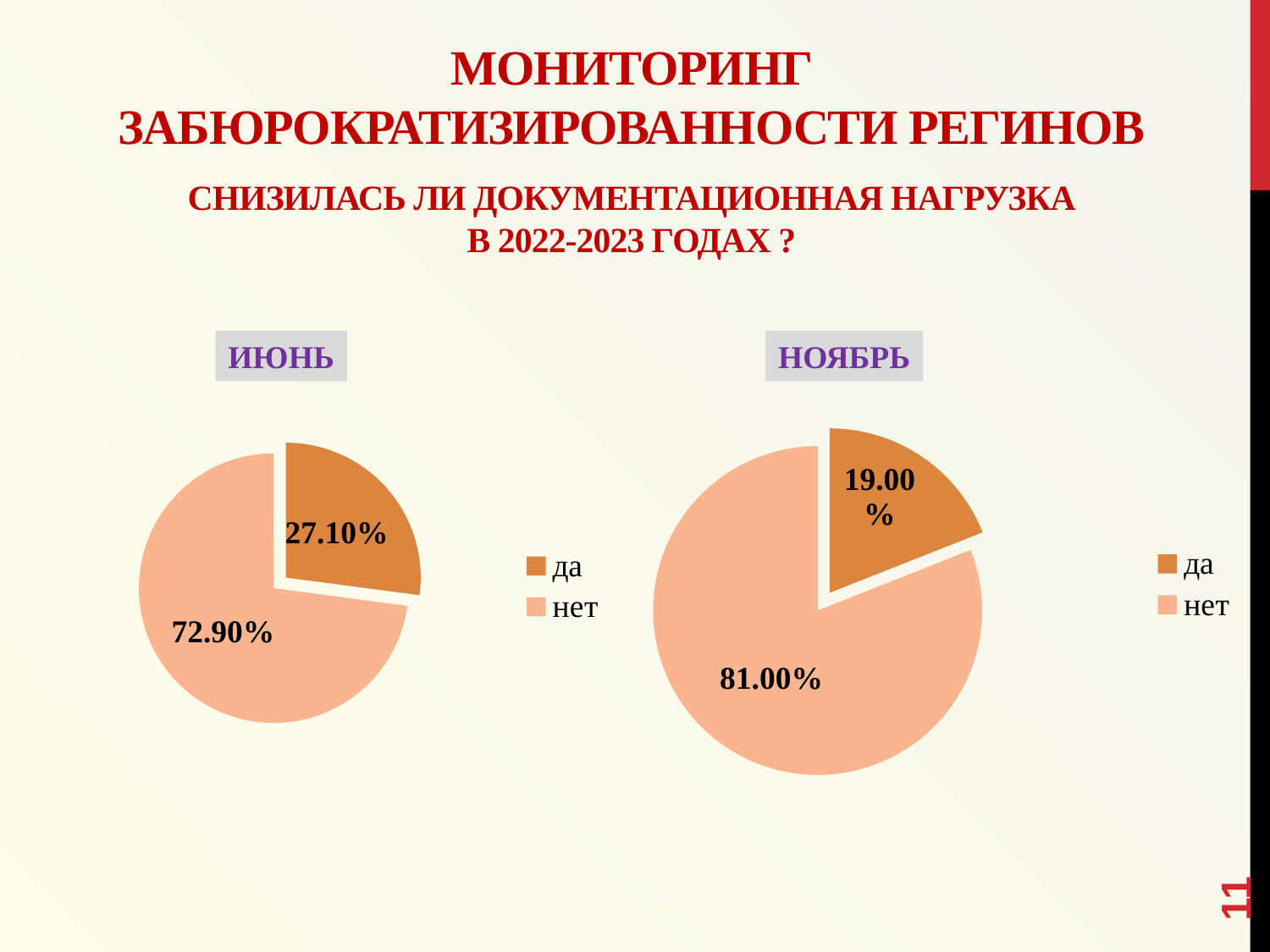
How many pie charts are shown on the slide? 2 In the НОЯБРЬ pie chart, what is the value for нет? 81.00% In the НОЯБРЬ pie chart, what is the value for да? 19.00% In the ИЮНЬ pie chart, what is the difference between the нет and да values? 45.80% In the ИЮНЬ pie chart, what is the value for да? 27.10% In the НОЯБРЬ pie chart, what is the difference between the нет and да values? 62.00% In the НОЯБРЬ pie chart, which category has the smallest slice? да How many categories does the legend of the НОЯБРЬ chart list? 2 In the ИЮНЬ pie chart, what is the value for нет? 72.90% What type of chart is used on the slide for ИЮНЬ and НОЯБРЬ? Pie chart Which chart has the larger value for да, ИЮНЬ or НОЯБРЬ? ИЮНЬ In the ИЮНЬ pie chart, which category has the largest slice? нет